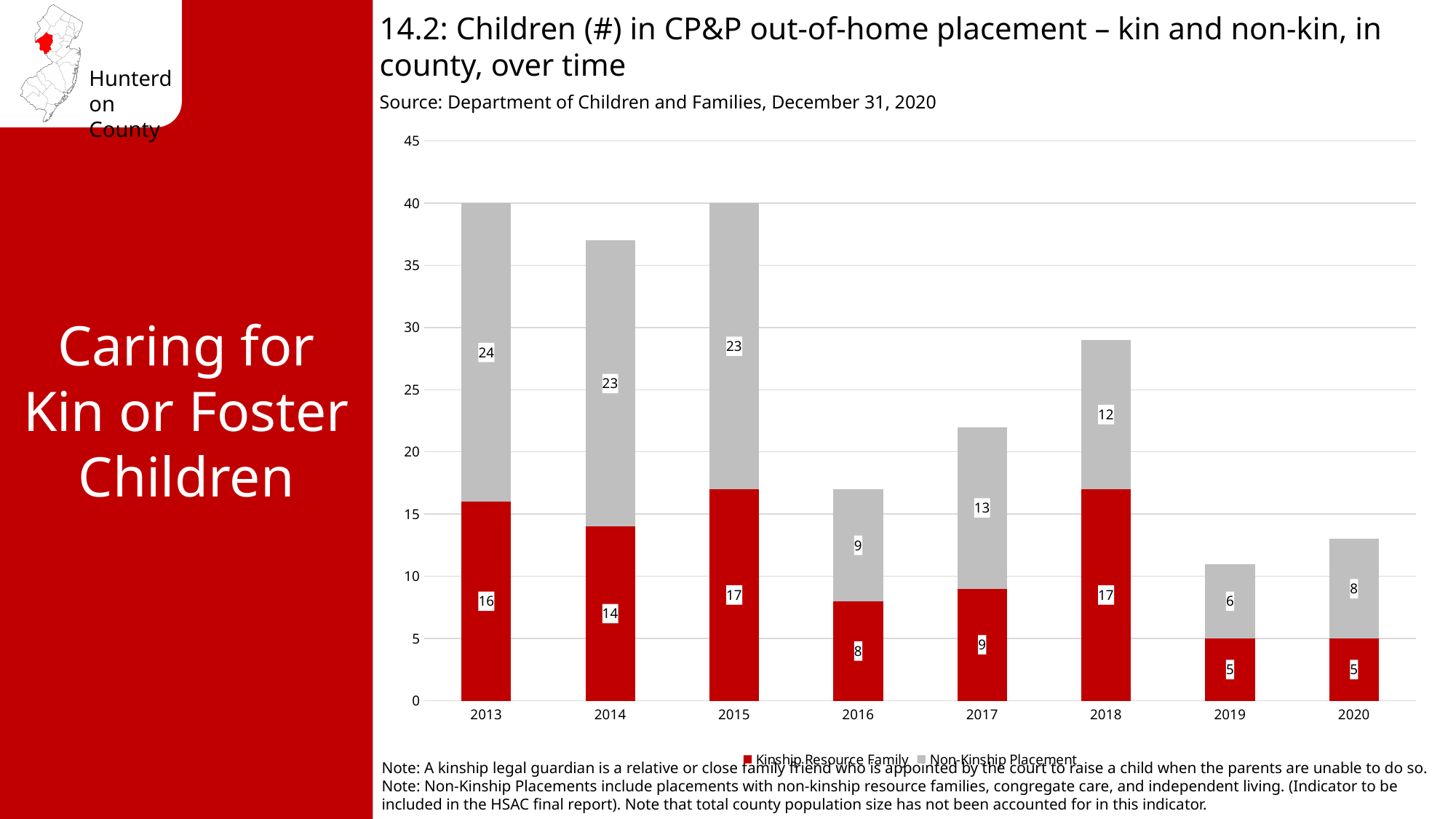
What type of chart is shown on the slide? Stacked bar chart What is the total number of children in out-of-home placement in 2016? 17 Which year has the lowest Non-Kinship Placement value? 2019 What is the Non-Kinship Placement value for 2017? 13 How many years are shown on the x axis? 8 What is the Kinship Resource Family value for 2020? 5 What is the difference between the Non-Kinship Placement value and the Kinship Resource Family value in 2014? 9 How many series does the legend list? 2 What is the total number of children in out-of-home placement in 2018? 29 What is the Kinship Resource Family value for 2015? 17 Which year has the highest Non-Kinship Placement value? 2013 Which is larger in 2018, the Kinship Resource Family value or the Non-Kinship Placement value? Kinship Resource Family